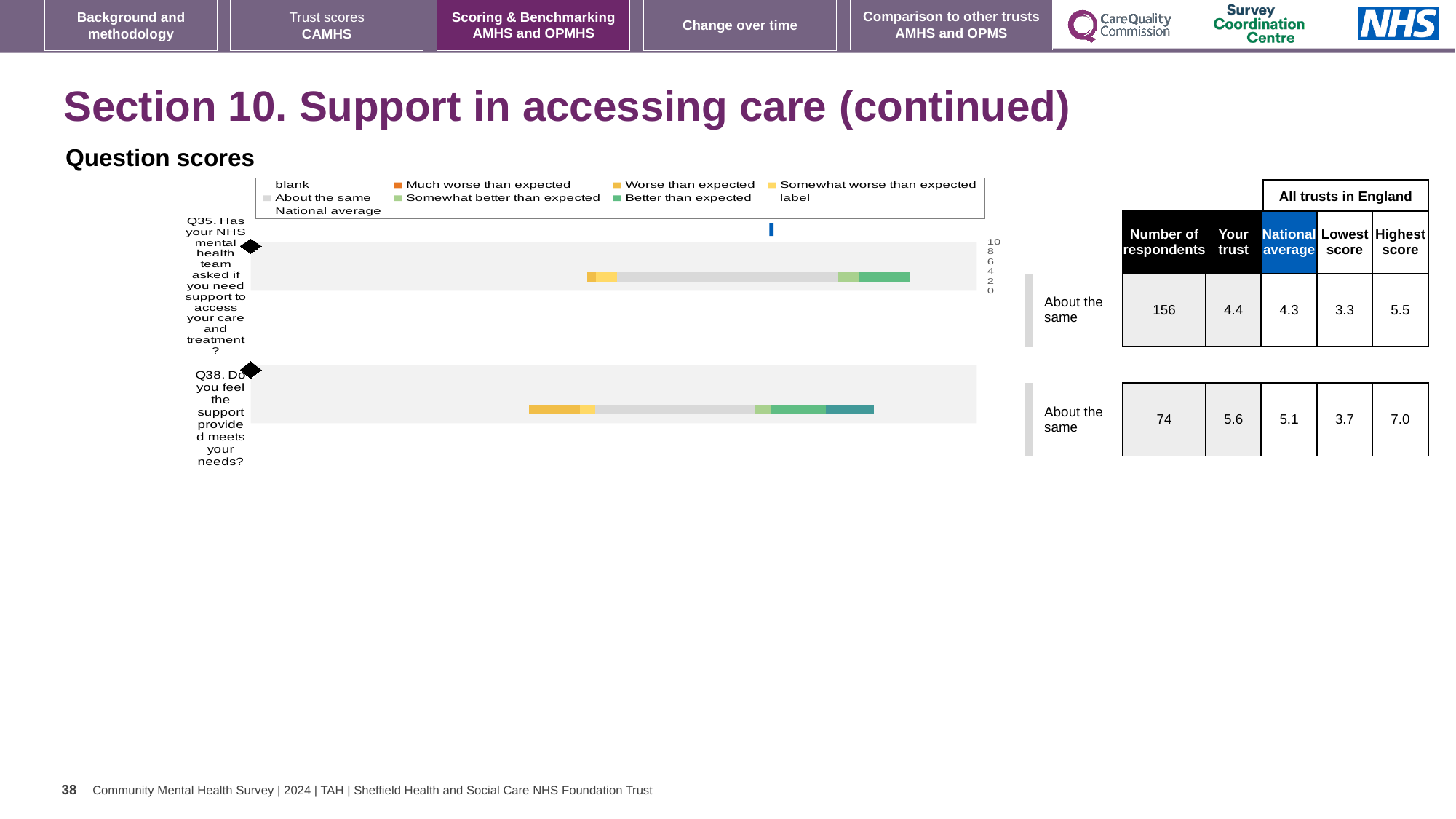
What is the 'Your trust' score for Q35 (Has your NHS mental health team asked if you need support to access your care and treatment?)? 4.4 What is the highest score across all trusts in England for Q38? 7.0 How many respondents answered Q35? 156 How many questions are plotted in the question scores chart? 2 What is the difference between the 'Your trust' score and the national average for Q35? 0.1 For Q38, which is larger: the 'Your trust' score or the national average? Your trust What is the lowest score across all trusts in England for Q35? 3.3 What benchmark category is shown next to the bar for Q38? About the same What is the national average score for Q38 (Do you feel the support provided meets your needs?)? 5.1 What is the difference between the highest and lowest scores for Q38? 3.3 What kind of chart is used to show the question scores on this slide? bar chart Which question has more respondents, Q35 or Q38? Q35